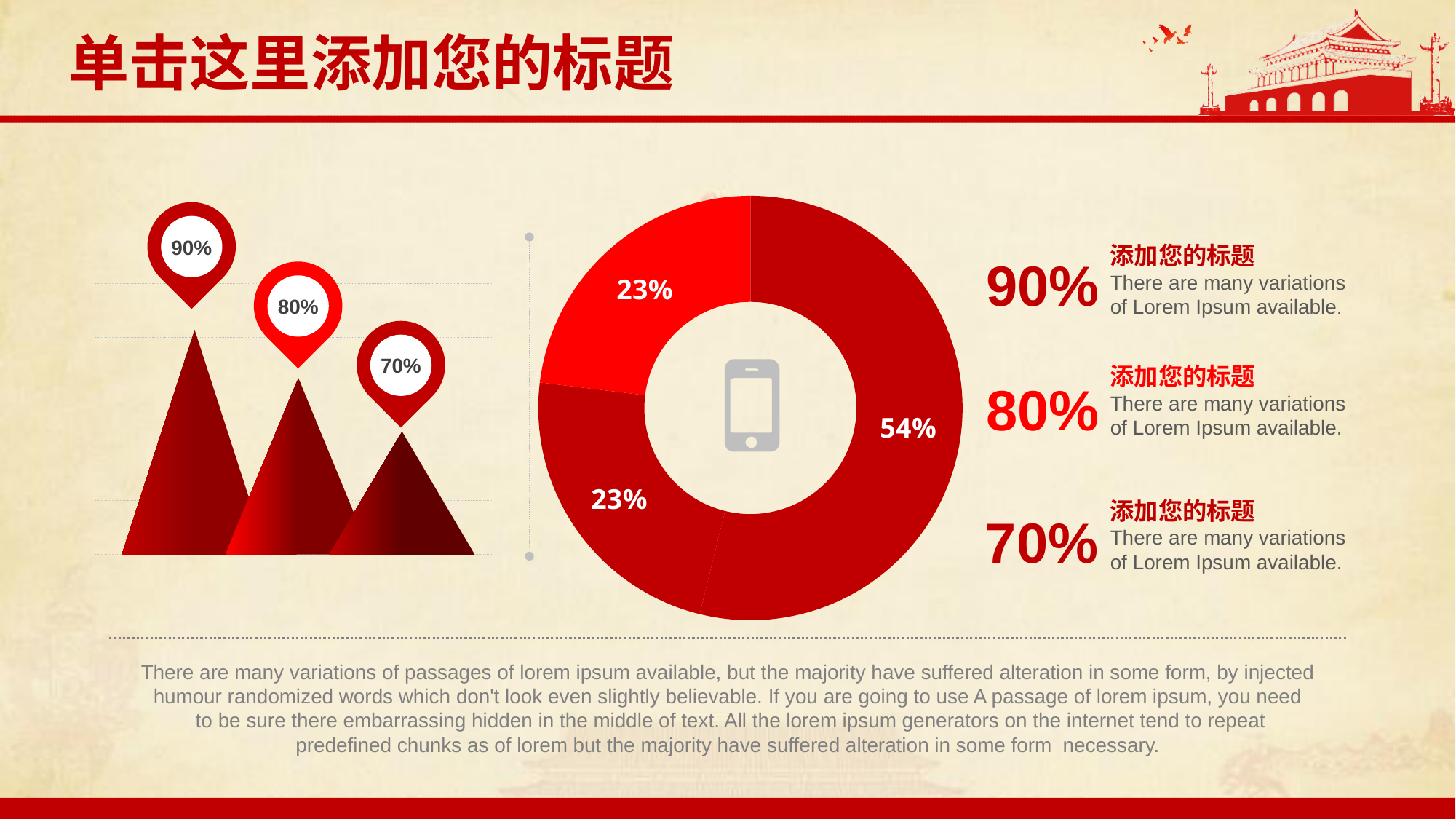
In the donut chart, what is the difference between the 54% slice and one of the 23% slices? 31 percentage points In the triangle chart on the left, do the values rise or fall from left to right? Fall In the donut chart, what share of the whole does the right-hand slice represent? 54% In the donut chart, is the 54% slice larger or smaller than the lower-left 23% slice? Larger In the donut chart, what is the value of the upper-left slice? 23% What kind of chart is the chart on the right side of the slide? Donut (pie) chart In the triangle chart on the left, what value is shown above the leftmost peak? 90% In the triangle chart on the left, what value is shown above the rightmost peak? 70% In the triangle chart on the left, what is the difference between the leftmost and rightmost peak values? 20 percentage points How many slices does the donut chart have? 3 In the donut chart, what is the value of the largest slice? 54% In the triangle chart on the left, how many peaks are shown? 3